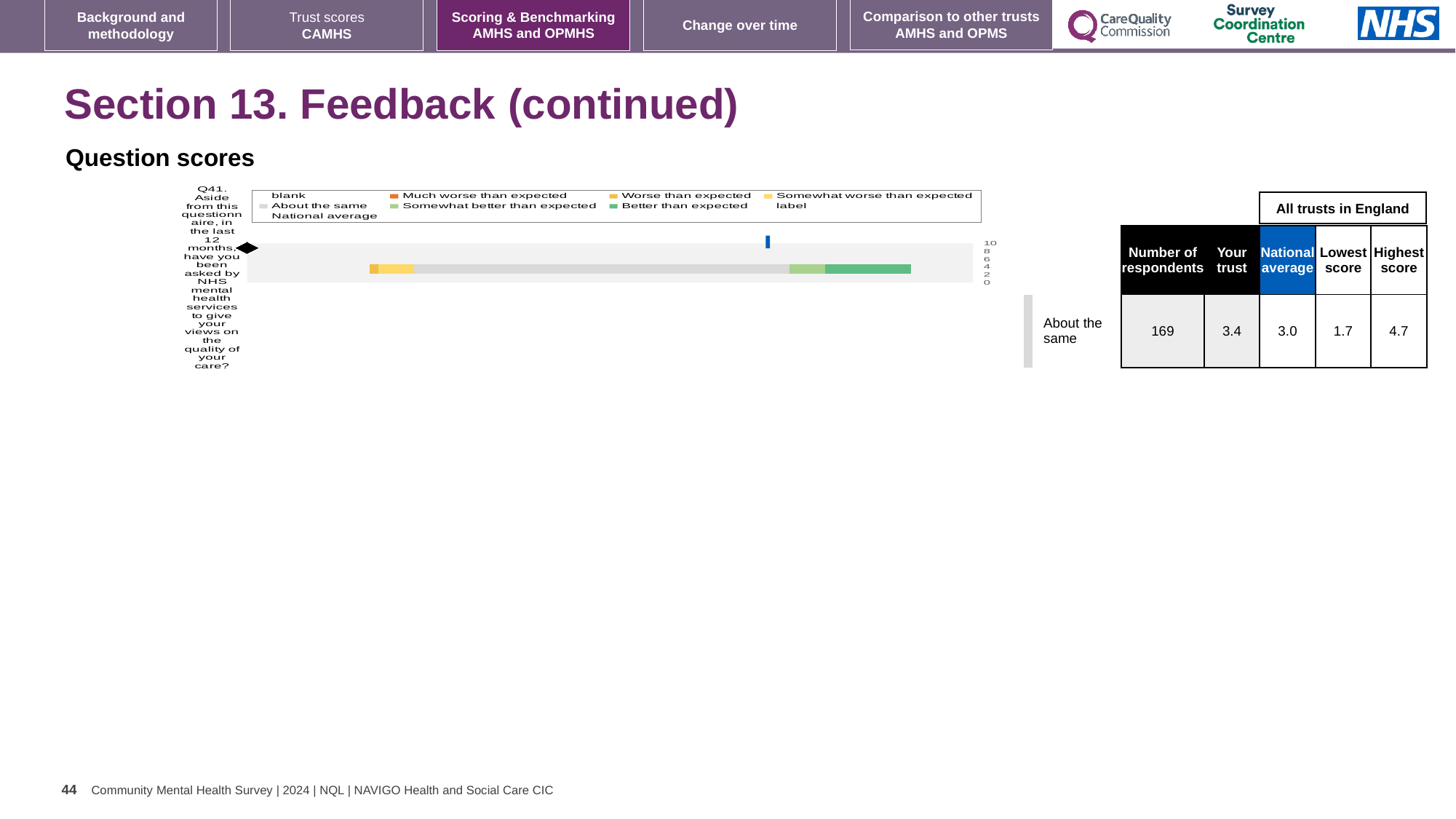
How many questions (categories) are plotted in the chart? 1 What is the national average score for Q41? 3.0 What colour does the legend use for 'Better than expected'? green What is the 'Your trust' score for Q41? 3.4 What is the highest score among all trusts in England for Q41? 4.7 How many respondents answered Q41? 169 Which is larger for Q41, the 'Your trust' score or the national average? Your trust What is the lowest score among all trusts in England for Q41? 1.7 What kind of chart is shown for Q41 on the slide? bar chart What is the difference between the highest score and the lowest score for Q41? 3.0 What is the difference between the 'Your trust' score and the national average for Q41? 0.4 How is the trust's result for Q41 categorised compared with other trusts? About the same